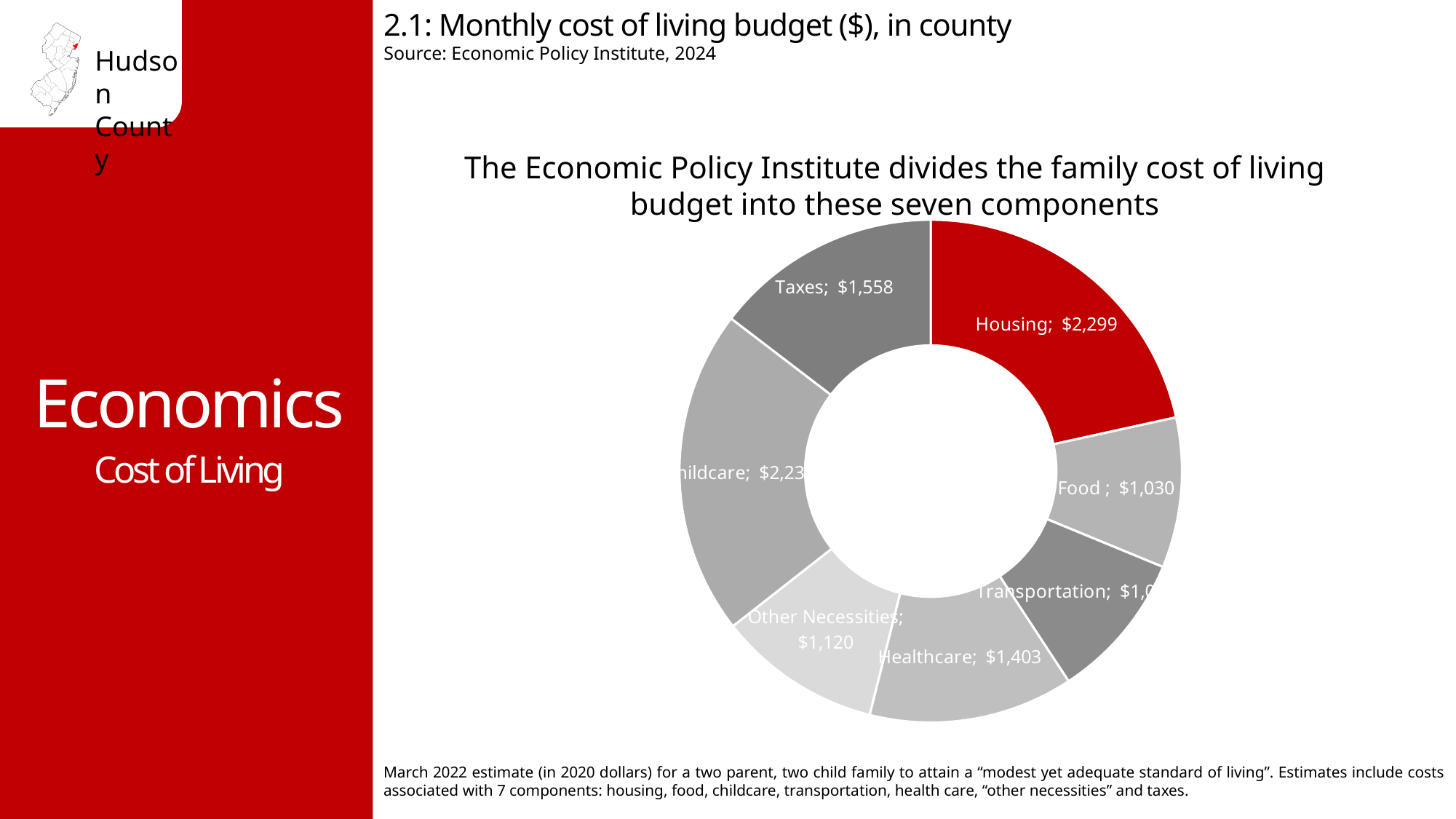
Which component has the highest monthly cost in the chart? Housing What is the monthly cost for Food in the chart? $1,030 What is the monthly cost for Housing in the chart? $2,299 What is the difference between the Housing cost and the Taxes cost? $741 How many components are shown in the chart? 7 What is the monthly cost for Healthcare in the chart? $1,403 What kind of chart is shown on the slide? Pie (donut) chart What is the difference between the Healthcare cost and the Food cost? $373 Which is larger, the cost for Other Necessities or the cost for Food? Other Necessities Which is larger, the cost for Taxes or the cost for Healthcare? Taxes What is the monthly cost for Other Necessities in the chart? $1,120 What is the monthly cost for Taxes in the chart? $1,558